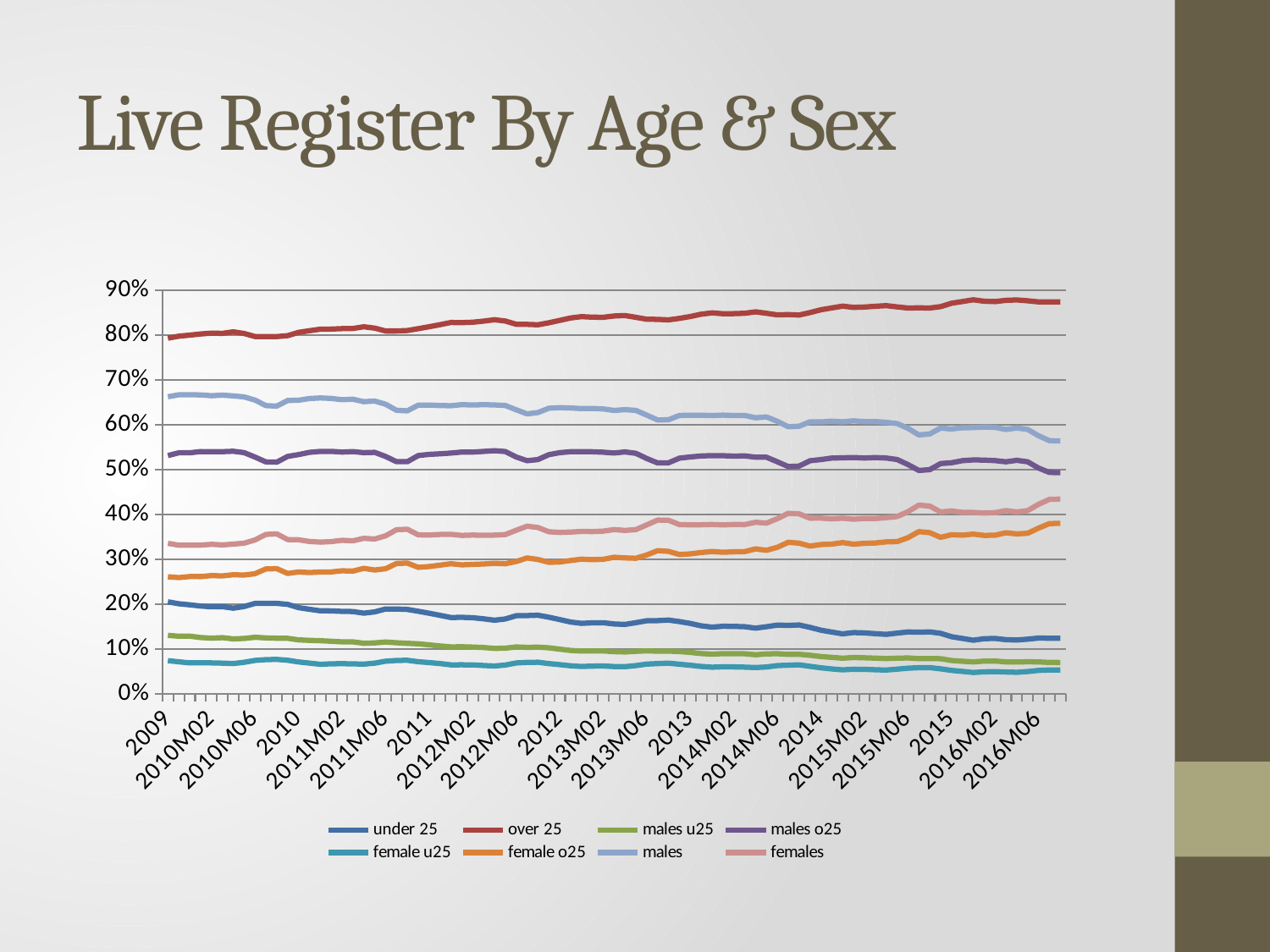
Does the 'under 25' series rise or fall from 2009 to 2016M06? fall How many series does the legend list? 8 Which series has the highest values across the whole period? over 25 Is the value for 'over 25' at 2009 greater or less than 70%? greater Which series has the lowest values across the whole period? female u25 Does the 'females' series rise or fall from 2009 to 2016M06? rise Does the 'males' series rise or fall from 2009 to 2016M06? fall What is the title of the slide? Live Register By Age & Sex At 2009, which is larger, 'males' or 'females'? males Is the value for 'under 25' at 2016M06 greater or less than 20%? less What kind of chart is shown on the slide? line chart